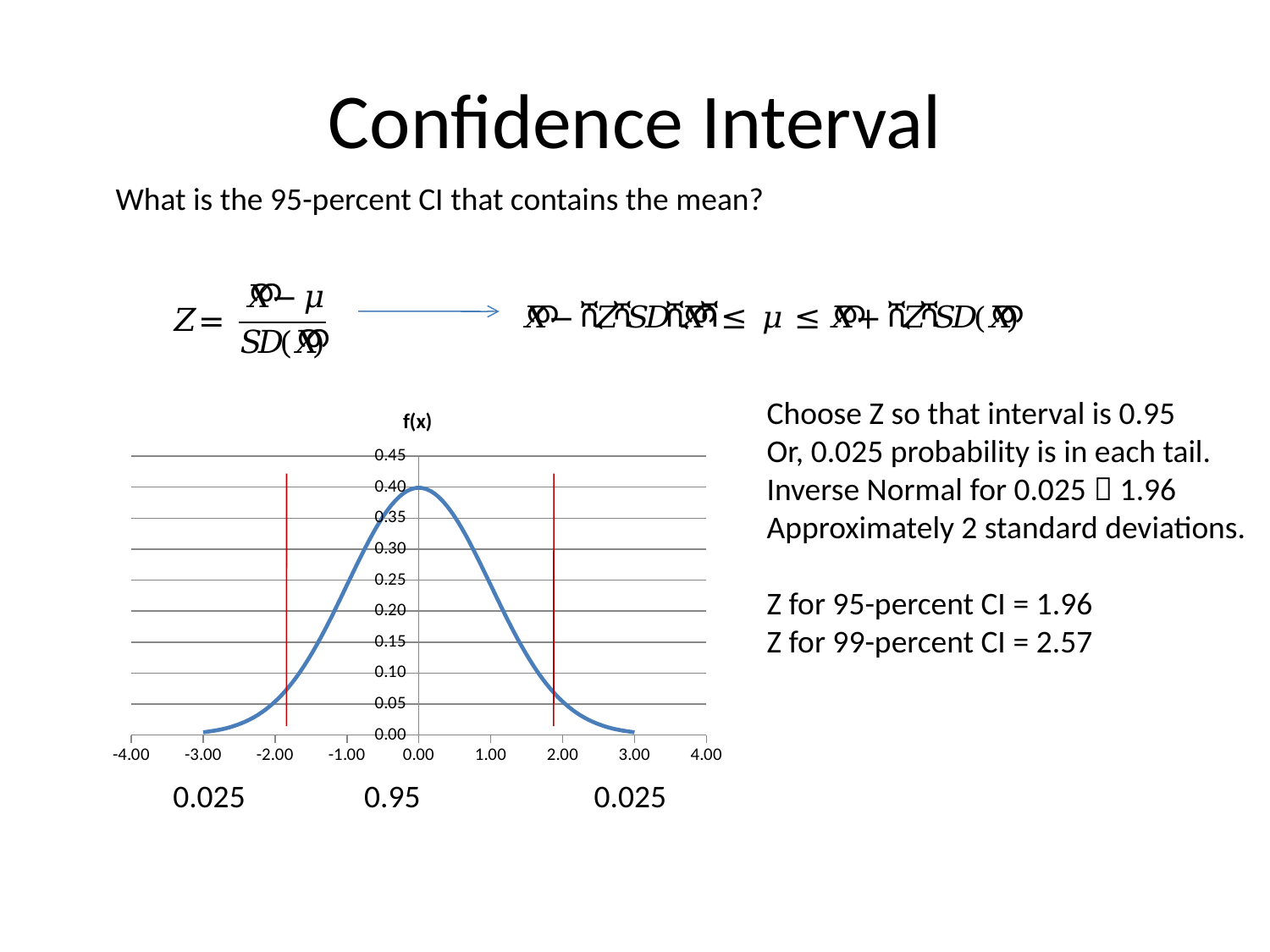
How many vertical red lines are drawn on the chart? 2 Is the value of the curve at x = 1.00 greater or less than 0.20? greater Which is larger, the value of the curve at x = 0.00 or at x = 2.00? x = 0.00 Does the curve rise or fall as x goes from 0.00 to 3.00? fall Is the value of the curve at x = 2.00 greater or less than 0.10? less Is the value of the curve at x = 3.00 greater or less than 0.05? less At which x value does the curve reach its highest point? 0.00 What is the title of the chart? f(x) What kind of chart is shown on the slide? line chart Does the curve rise or fall as x goes from -3.00 to 0.00? rise